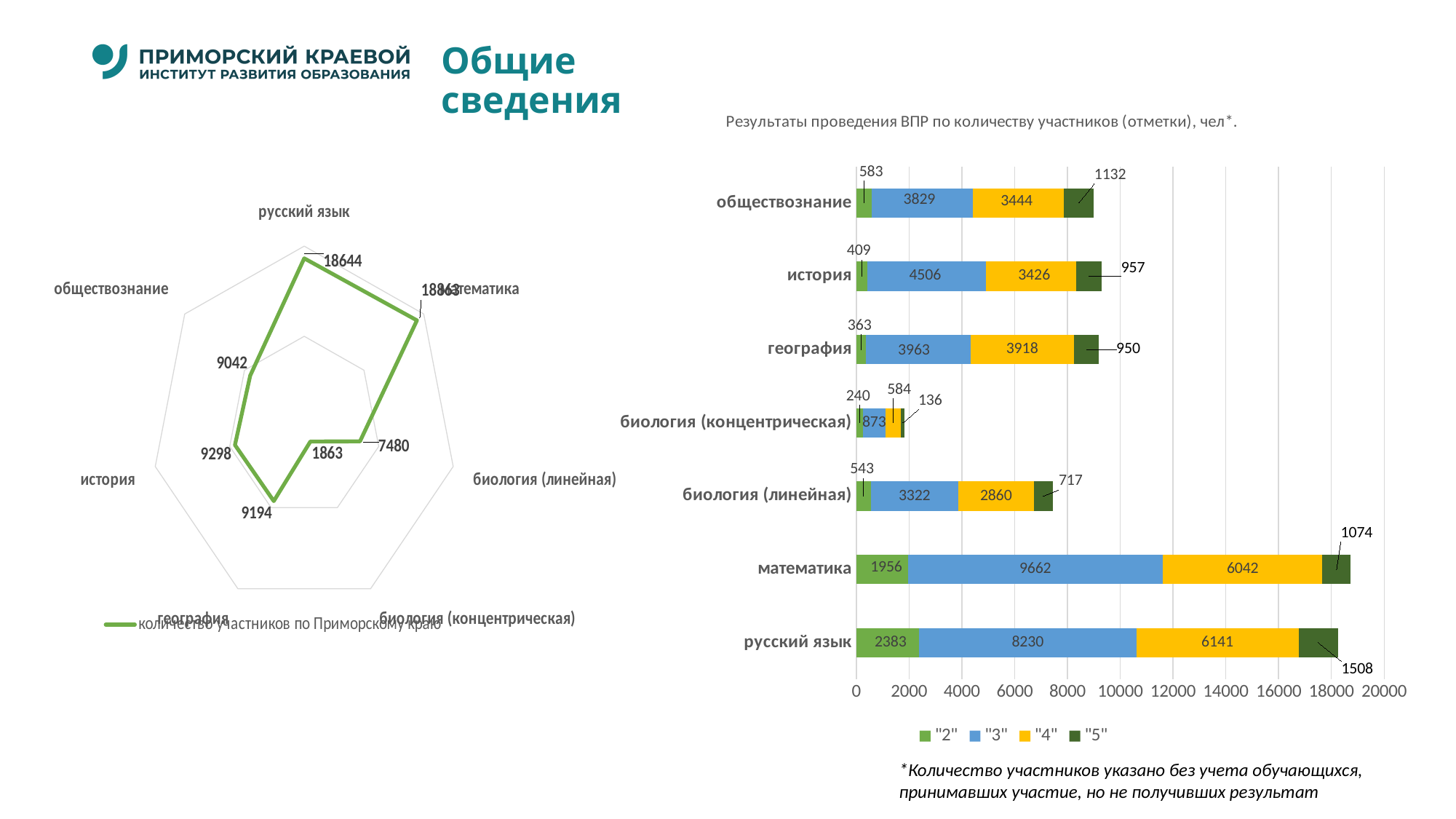
In the stacked bar chart on the right, which is larger: the "3" value for география or the "3" value for история? история In the radar chart on the left, what is the number of participants for биология (линейная)? 7480 What type of chart is the chart on the left of the slide? radar chart In the stacked bar chart on the right, which subject has the smallest number of participants with a "5"? биология (концентрическая) How many series does the legend of the stacked bar chart on the right list? 4 In the stacked bar chart on the right, how many participants received a "3" in математика? 9662 In the stacked bar chart on the right, what is the total number of participants for история across all four marks? 9298 In the stacked bar chart on the right, how many participants received a "5" in русский язык? 1508 In the radar chart on the left, which subject has the lowest number of participants? биология (концентрическая) In the stacked bar chart on the right, what is the difference between the "4" values for русский язык and математика? 99 In the stacked bar chart on the right, how many participants received a "2" in история? 409 How many subjects are shown in the stacked bar chart on the right? 7